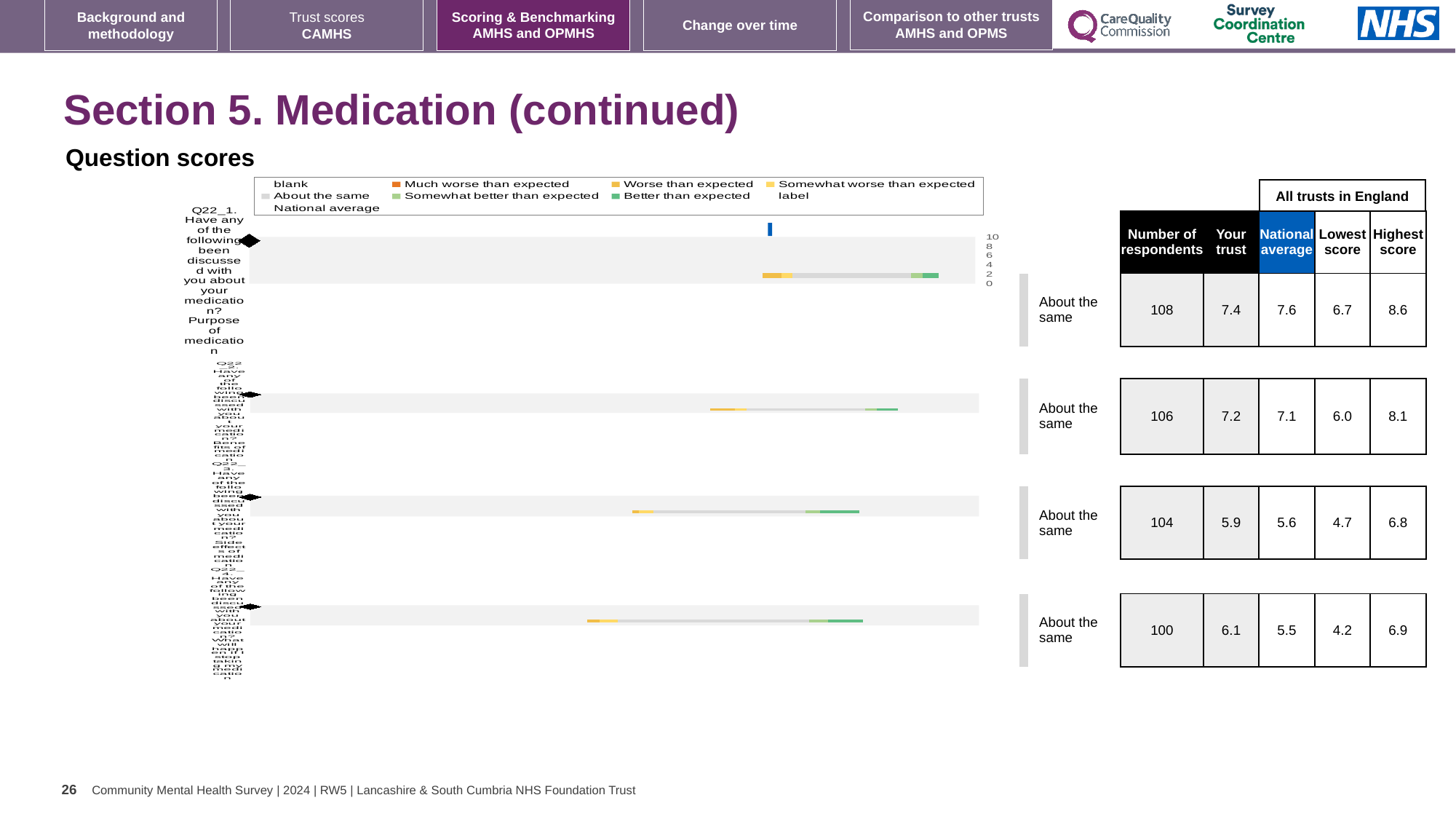
What colour does the legend use for 'Better than expected'? green What benchmark category is shown for each of the four questions? About the same How many respondents answered Q22_4? 100 Is the 'Your trust' score for Q22_4 larger than its national average? Yes Which question has the lowest 'Lowest score' across all trusts in England? Q22_4 What kind of chart is shown on the slide? bar chart What is the 'Your trust' score for Q22_1 (Purpose of medication)? 7.4 How many question bars (Q22_1 to Q22_4) are plotted in the chart? 4 What is the difference between the highest score and the lowest score for Q22_2? 2.1 What is the national average for Q22_3 (Side effects of medication)? 5.6 Which question has the highest 'Your trust' score? Q22_1 What colour does the legend use for 'Much worse than expected'? orange